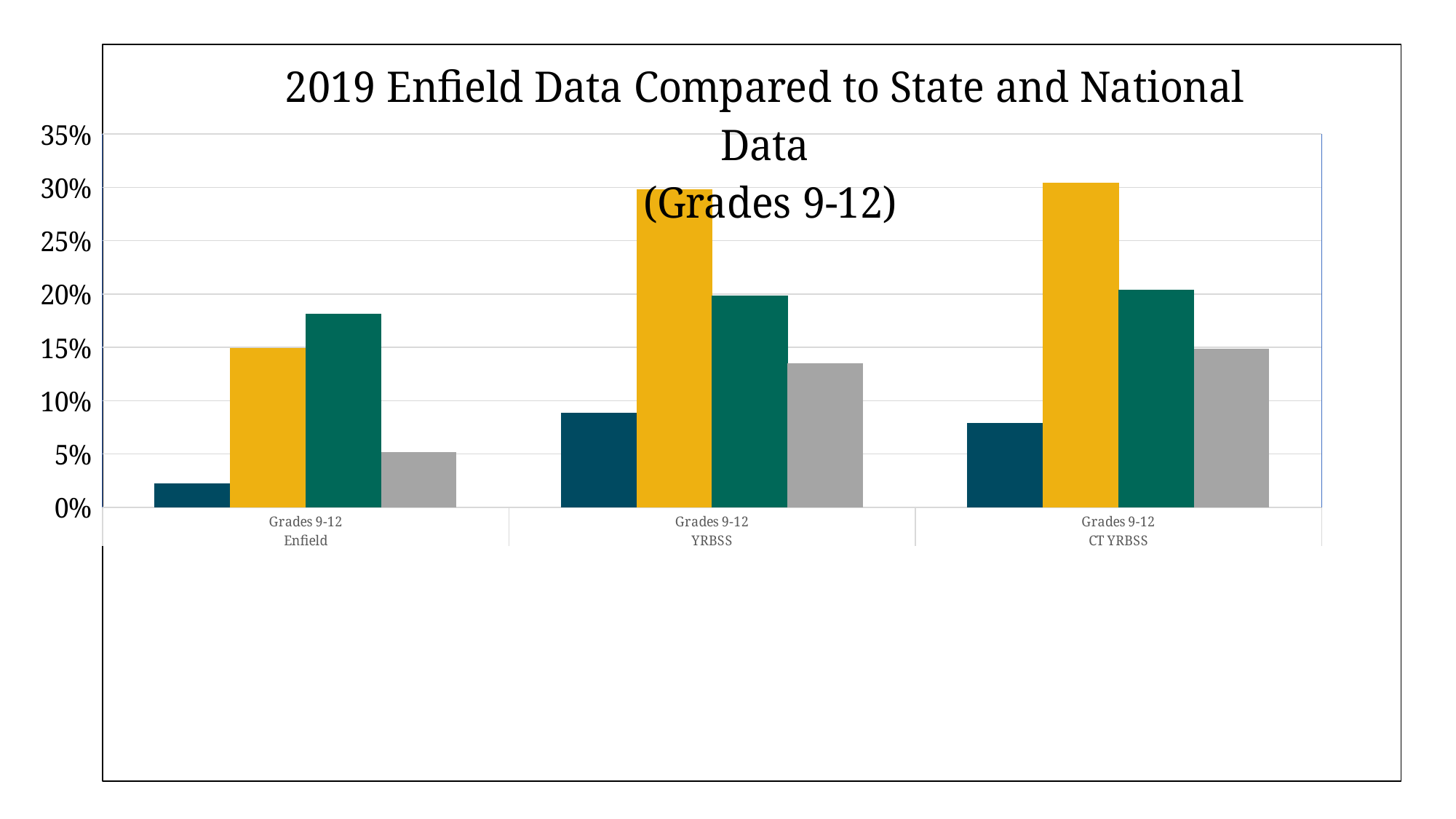
For Grades 9-12 Enfield, which is larger, the yellow bar or the green bar? the green bar What is the title of the chart? 2019 Enfield Data Compared to State and National Data (Grades 9-12) Is the value of the dark blue bar for Grades 9-12 YRBSS greater or less than 10%? less Is the value of the yellow bar for Grades 9-12 Enfield greater or less than 20%? less How many categories are shown on the x axis? 3 Is the value of the gray bar for Grades 9-12 Enfield greater or less than 10%? less How many bars are plotted for each category? 4 Which category has the lowest dark blue bar? Grades 9-12 Enfield What kind of chart is shown on the slide? bar chart